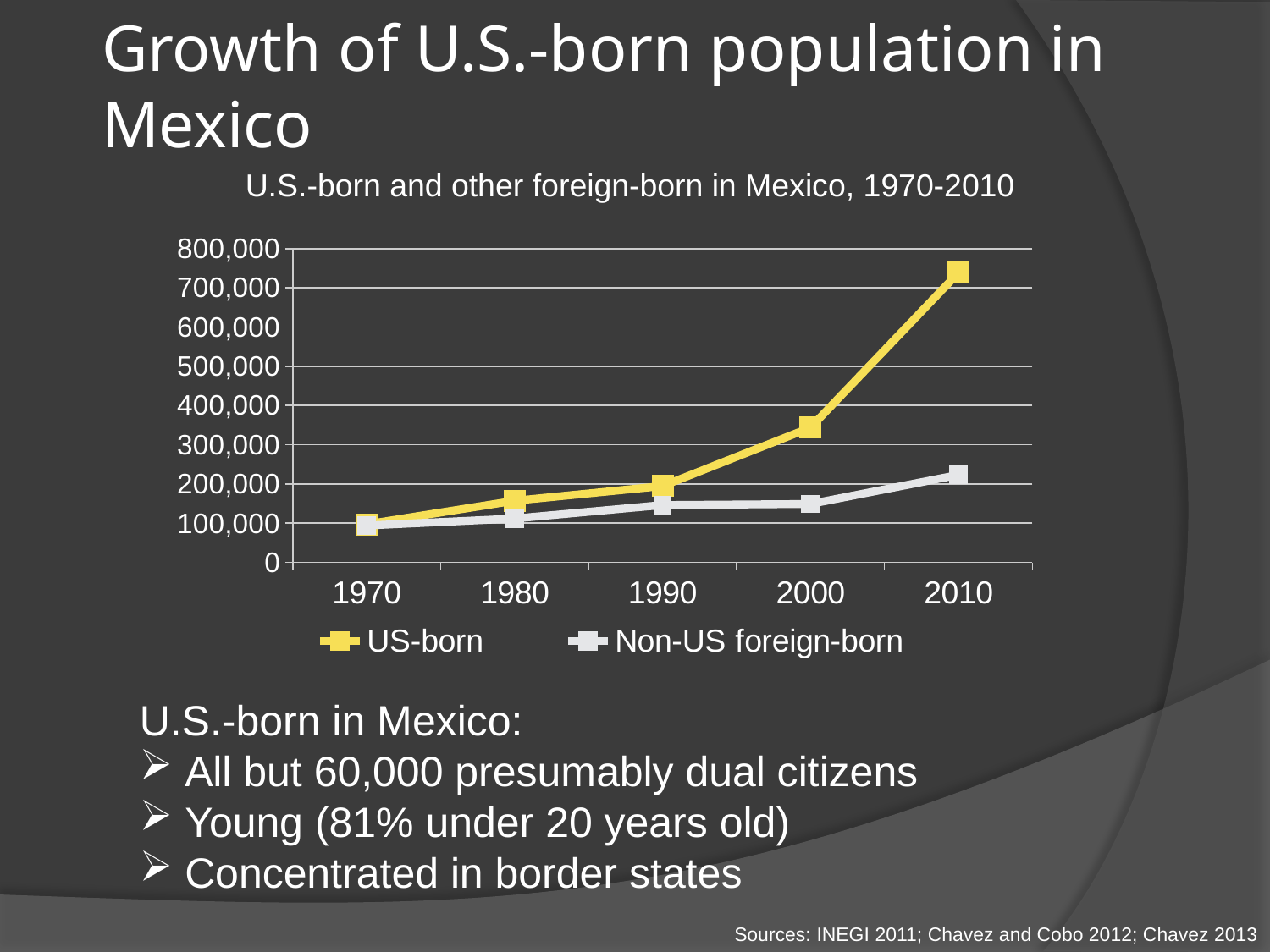
Is the US-born value for 2000 greater or less than 300,000? greater How many series does the legend list? 2 In 2010, which series has the larger value, US-born or Non-US foreign-born? US-born In which year is the US-born value highest? 2010 Does the US-born series rise or fall from 1970 to 2010? Rise What kind of chart is shown on the slide? Line chart What is the title of the chart? U.S.-born and other foreign-born in Mexico, 1970-2010 Is the Non-US foreign-born value for 2010 greater or less than 300,000? less How many years are plotted along the x axis? 5 Is the US-born value for 2010 greater or less than 700,000? greater In which year is the Non-US foreign-born value lowest? 1970 Which series is drawn in yellow? US-born